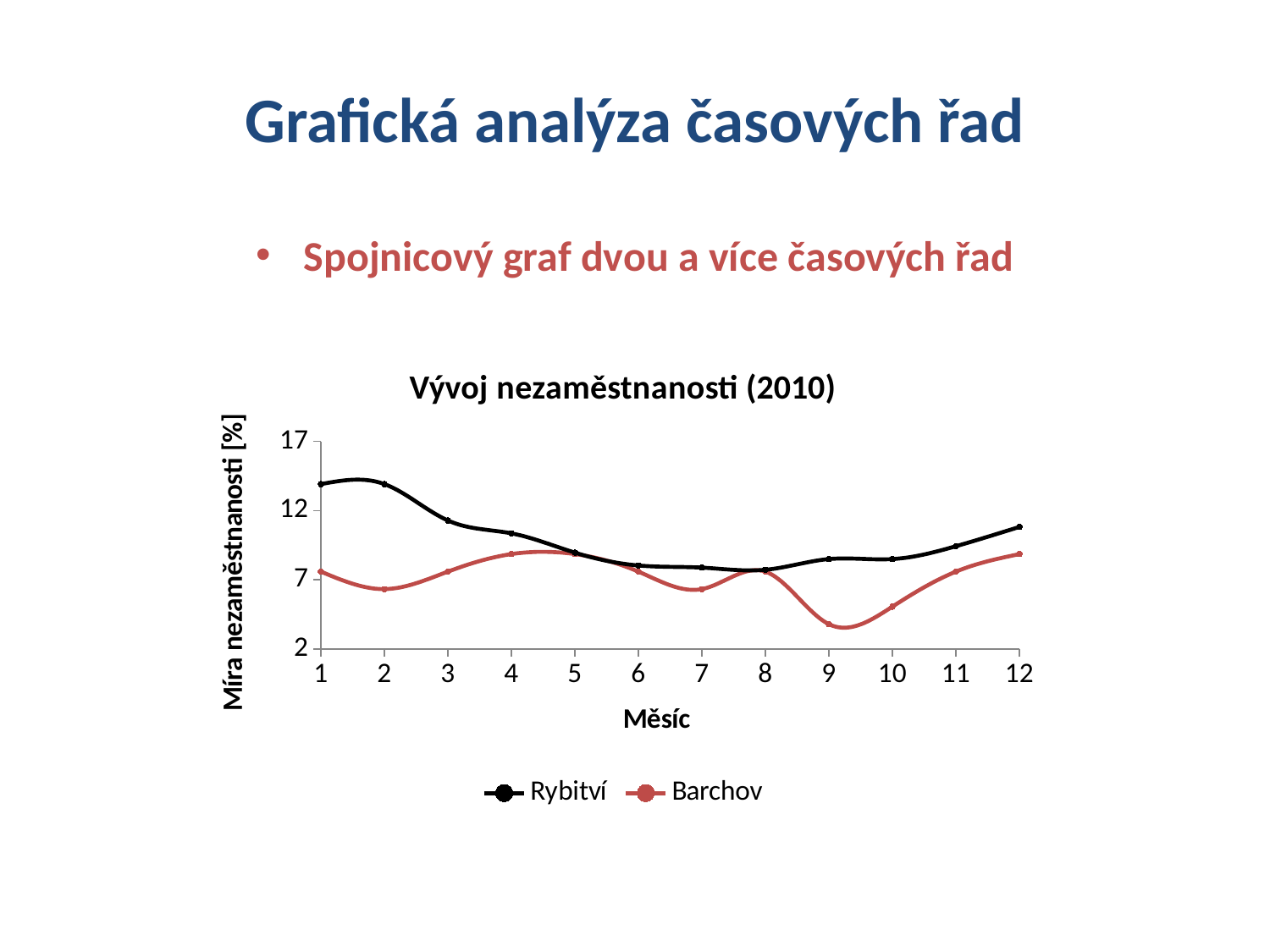
How many months are plotted along the x axis of the chart? 12 Is the value for Barchov in month 2 greater or less than 7? less Is the value for Rybitví in month 12 greater or less than 7? greater In month 1, which series has the higher value, Rybitví or Barchov? Rybitví Does the Rybitví series rise or fall from month 1 to month 8? fall What kind of chart is shown on the slide? line chart Is the value for Barchov in month 9 greater or less than 7? less How many series does the legend of the chart list? 2 In which month does the Barchov series reach its lowest value? 9 In month 9, which series has the higher value, Rybitví or Barchov? Rybitví What is the title of the chart? Vývoj nezaměstnanosti (2010)